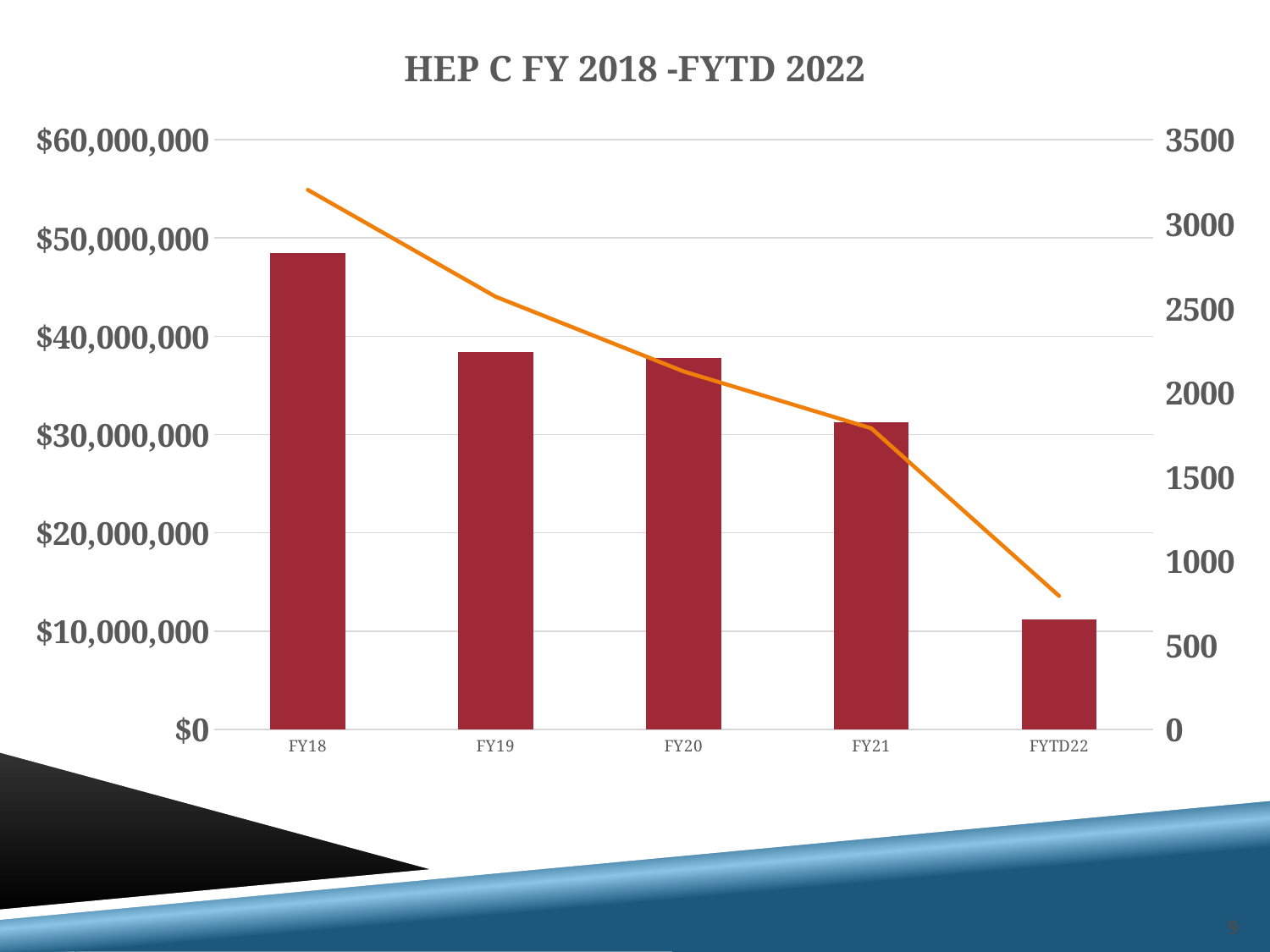
Which has the larger bar value, FY18 or FY21? FY18 Does the orange line rise or fall from FY18 to FYTD22? Fall Is the bar value for FYTD22 greater or less than $20,000,000? less What is the title of the chart? HEP C FY 2018 -FYTD 2022 Is the orange line value for FY18 greater or less than 3000 on the right axis? greater How many fiscal-year categories are shown on the x axis? 5 Do the bar values rise or fall from FY18 to FYTD22? Fall Which category has the tallest bar? FY18 Which category has the shortest bar? FYTD22 What is the highest value shown on the right-hand axis? 3500 What kind of chart is shown on the slide? A combination bar and line chart Is the bar value for FY18 greater or less than $40,000,000? greater